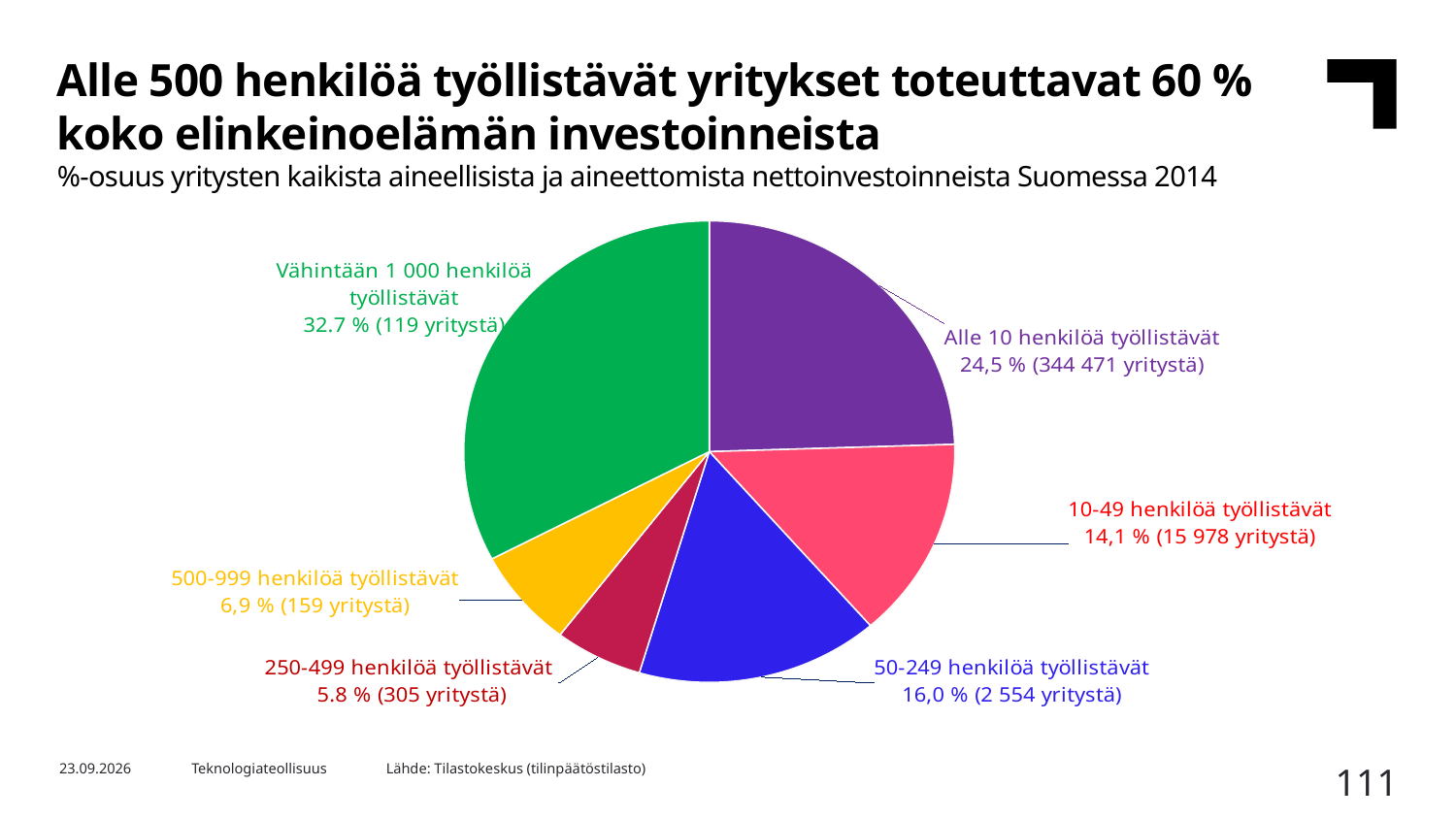
What colour is the slice for 500-999 henkilöä työllistävät? Yellow What type of chart is shown on the slide? Pie chart How many companies are in the 50-249 henkilöä työllistävät group? 2 554 yritystä Which company size group has the largest share of investments? Vähintään 1 000 henkilöä työllistävät How many companies are in the Alle 10 henkilöä työllistävät group? 344 471 yritystä How many slices does the pie chart have? 6 Which has a larger share of investments: 500-999 henkilöä työllistävät or 250-499 henkilöä työllistävät? 500-999 henkilöä työllistävät What year does the chart's data refer to, according to the subtitle? 2014 Which company size group has the smallest share of investments? 250-499 henkilöä työllistävät What share of investments is attributed to companies employing at least 1 000 people (Vähintään 1 000 henkilöä työllistävät)? 32.7 % What is the difference in percentage points between the 50-249 henkilöä työllistävät share and the 10-49 henkilöä työllistävät share? 1,9 percentage points What share of investments is attributed to companies employing fewer than 10 people (Alle 10 henkilöä työllistävät)? 24,5 %